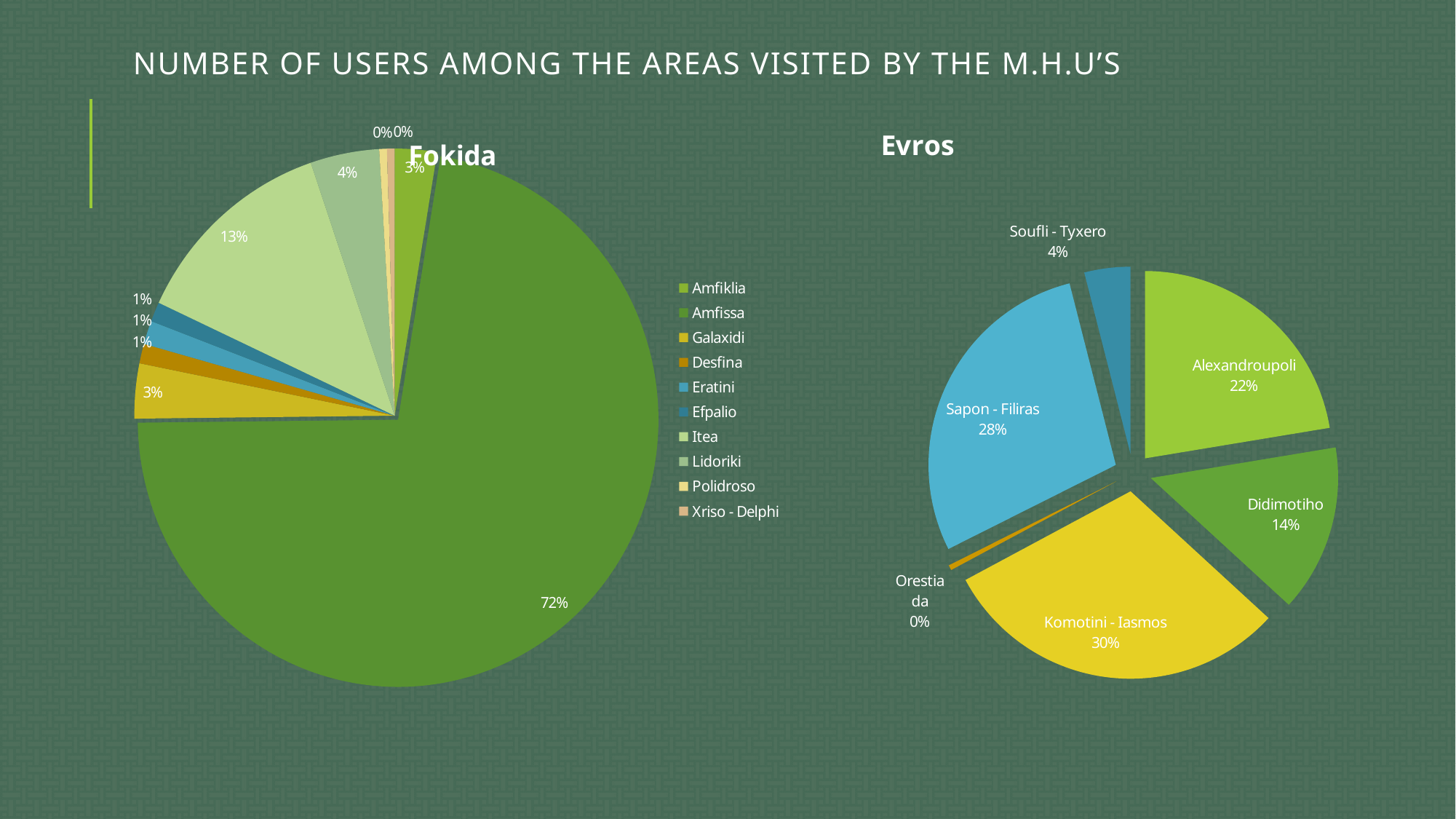
In the Evros chart, what share of users does Komotini - Iasmos account for? 30% What type of chart is used for Fokida and Evros? Pie chart In the Fokida chart, what percentage is shown for the largest slice? 72% In the Evros chart, which area has the smallest share of users? Orestiada How many areas are shown in the Evros chart? 6 In the Fokida chart, which area has the largest share of users? Amfissa In the Evros chart, what percentage is shown for Sapon - Filiras? 28% In the Evros chart, what percentage is shown for Alexandroupoli? 22% In the Evros chart, what is the difference in percentage points between Alexandroupoli and Didimotiho? 8 In the Evros chart, which has a larger share: Sapon - Filiras or Didimotiho? Sapon - Filiras In the Evros chart, which area has the largest share of users? Komotini - Iasmos How many areas does the legend of the Fokida chart list? 10